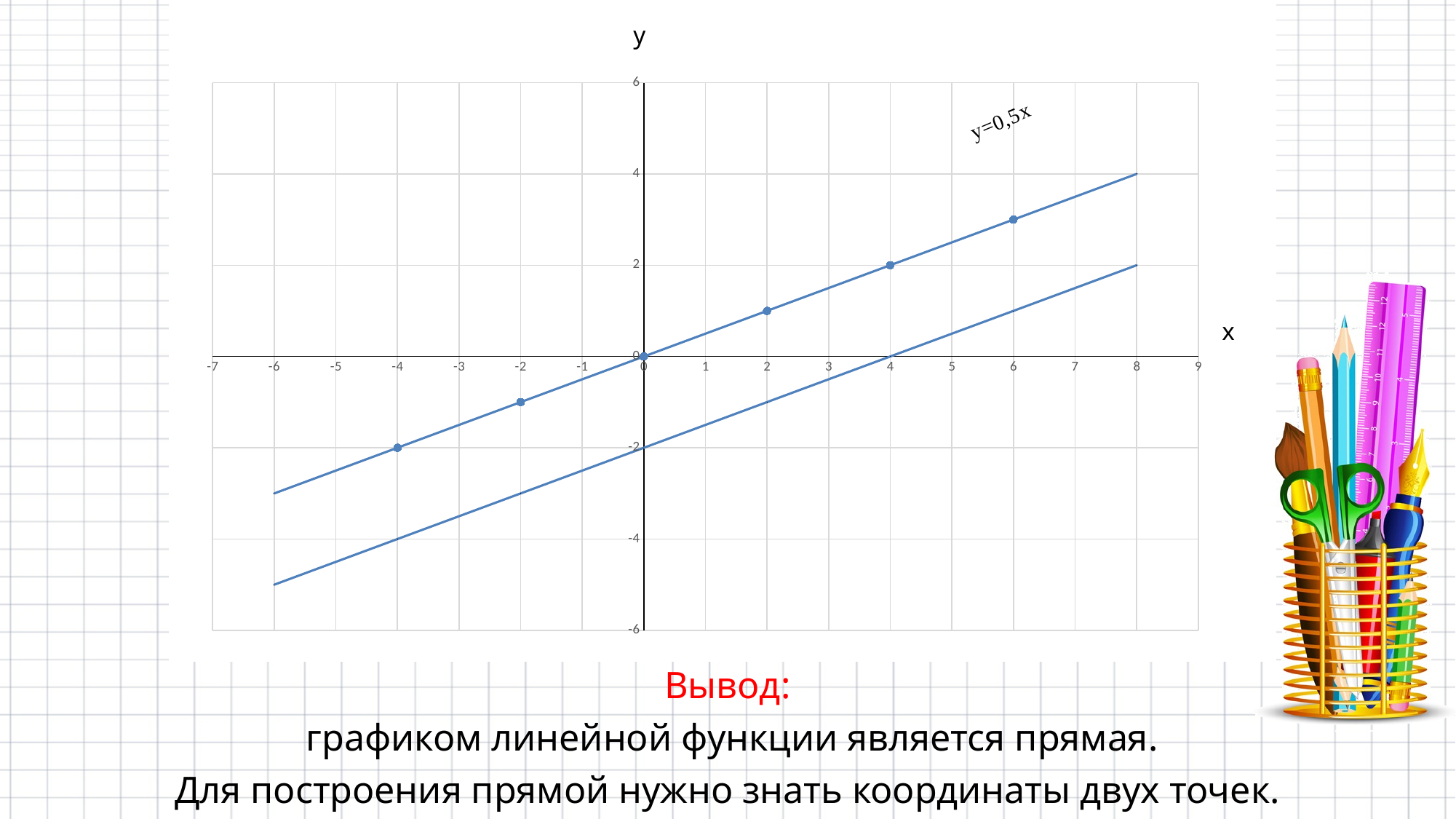
What is the y value of the marked point at x = 2 on the line labelled y=0,5x? 1 How many straight lines are plotted on the chart? 2 What is the y value of the lower line at x = 0? -2 What is the y value of the marked point at x = -4 on the line labelled y=0,5x? -2 At x = 2, which line has the larger y value, the upper line y=0,5x or the lower line? the upper line y=0,5x How many marked data points are shown on the line labelled y=0,5x? 6 What is the y value of the marked point at x = 6 on the line labelled y=0,5x? 3 Do the plotted lines rise or fall as x increases? rise Which marked point on the line y=0,5x has the highest y value? the point at x = 6 At which x value does the lower line cross the x axis? 4 What kind of chart is shown on the slide? line chart What equation label is printed on the chart next to the upper line? y=0,5x